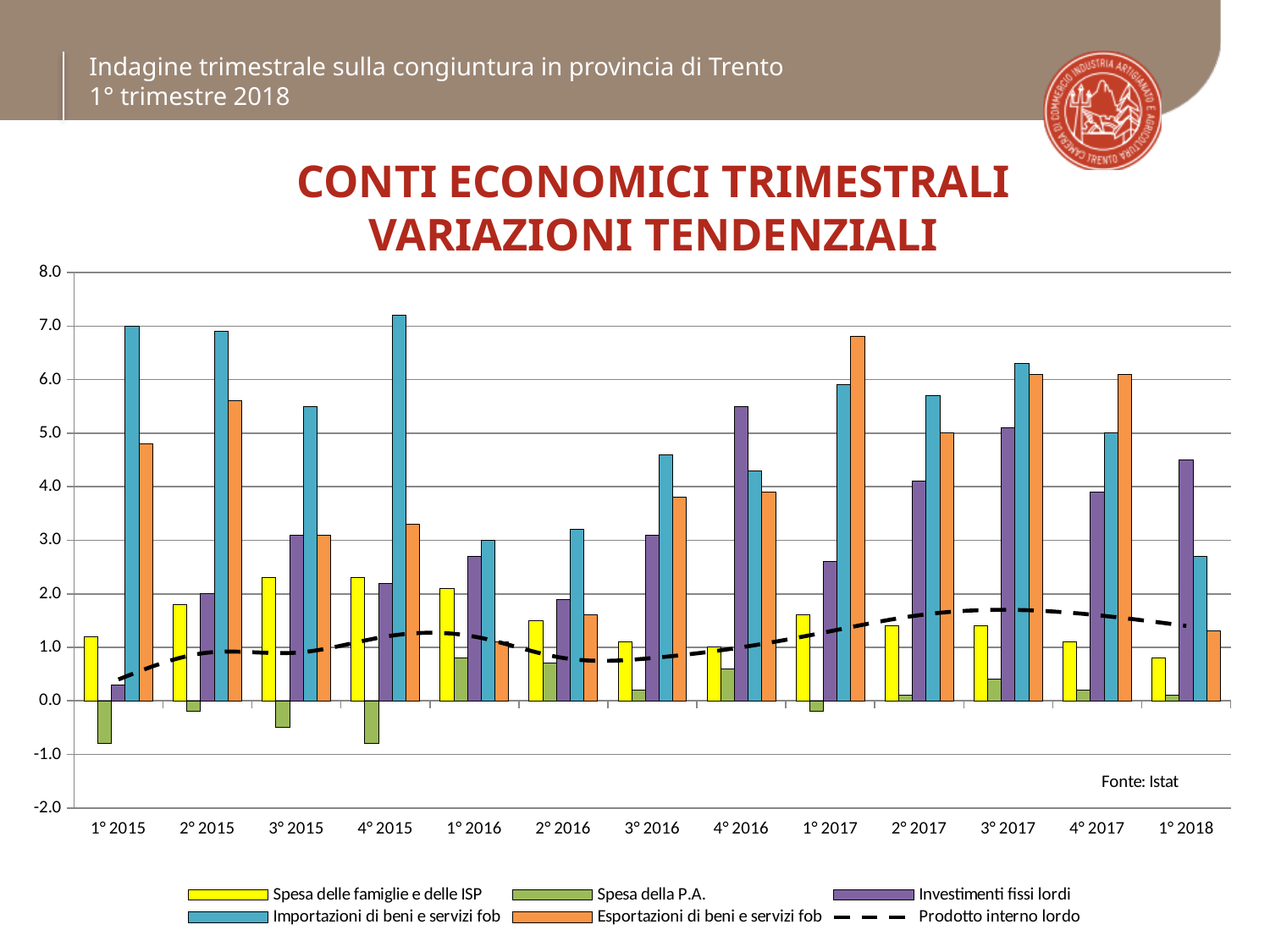
In 1° 2018, which is larger: Investimenti fissi lordi or Importazioni di beni e servizi fob? Investimenti fissi lordi Is the value for Investimenti fissi lordi in 4° 2016 greater or less than 5.0? greater Which series is drawn as a dashed line in the chart? Prodotto interno lordo Is the value for Spesa delle famiglie e delle ISP in 1° 2018 greater or less than 1.0? less How many quarters are shown along the x axis of the chart? 13 Is the value for Esportazioni di beni e servizi fob in 1° 2017 greater or less than 6.0? greater What kind of chart is shown on the slide? bar and line chart How many series does the legend of the chart list? 6 In 1° 2017, which is larger: Esportazioni di beni e servizi fob or Importazioni di beni e servizi fob? Esportazioni di beni e servizi fob In which quarter is Esportazioni di beni e servizi fob highest? 1° 2017